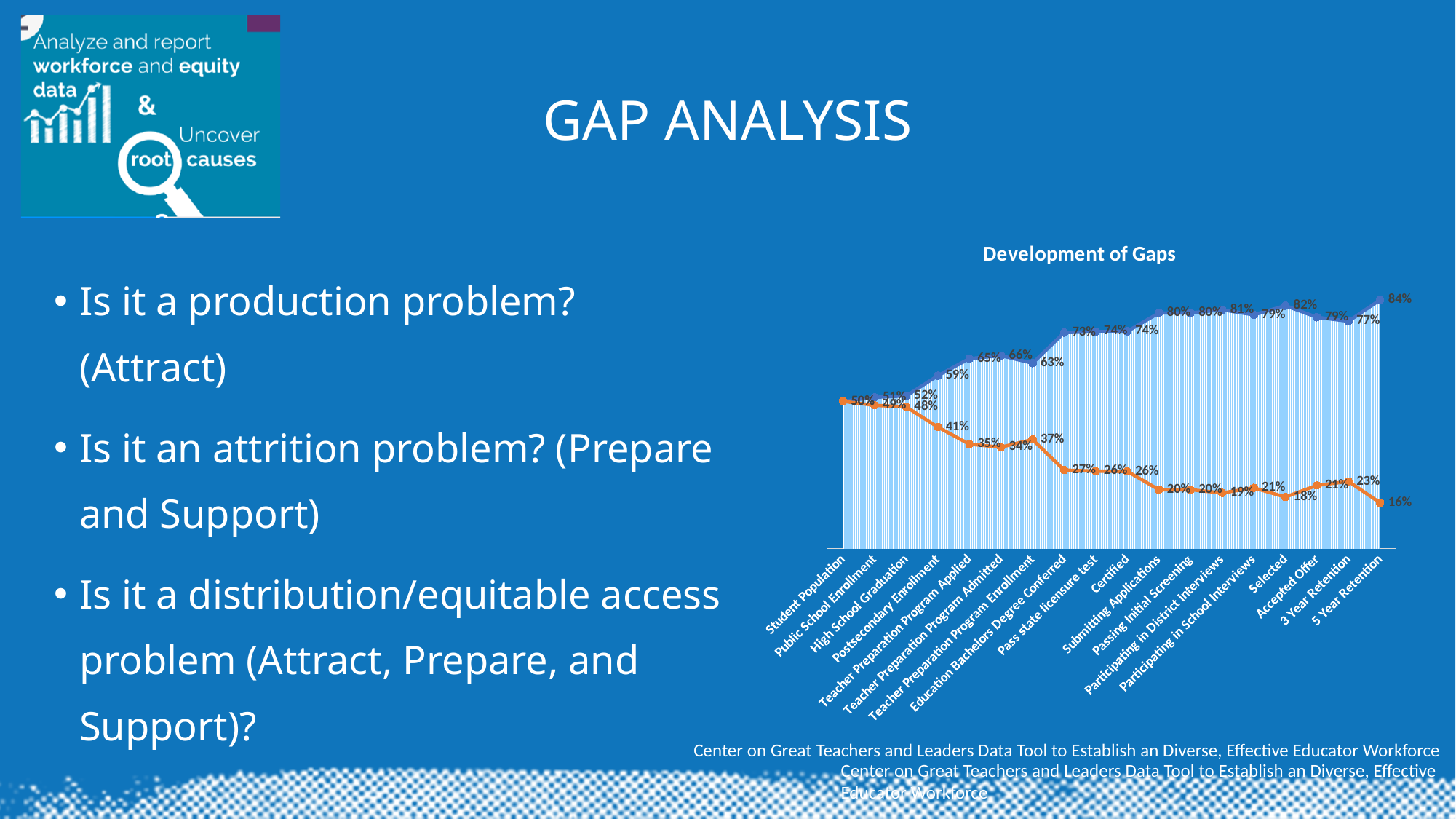
In the 'Development of Gaps' chart, is the upper (blue) line higher at Certified or at Teacher Preparation Program Enrollment? Certified In the 'Development of Gaps' chart, what is the value of the upper (blue) line at 5 Year Retention? 84% In the 'Development of Gaps' chart, at which category does the upper (blue) line reach its highest value? 5 Year Retention In the 'Development of Gaps' chart, what is the value of the lower (orange) line at 5 Year Retention? 16% In the 'Development of Gaps' chart, does the lower (orange) line generally rise or fall from Student Population to 5 Year Retention? fall In the 'Development of Gaps' chart, what is the difference between the upper (blue) line and the lower (orange) line at 5 Year Retention? 68 percentage points In the 'Development of Gaps' chart, what is the value of the lower (orange) line at Postsecondary Enrollment? 41% In the 'Development of Gaps' chart, at which category does the lower (orange) line reach its lowest value? 5 Year Retention In the 'Development of Gaps' chart, what is the value of the upper (blue) line at Selected? 82% How many categories are shown along the x axis of the 'Development of Gaps' chart? 18 What is the title of the chart on the slide? Development of Gaps What kind of chart is the 'Development of Gaps' chart? combination area and line chart